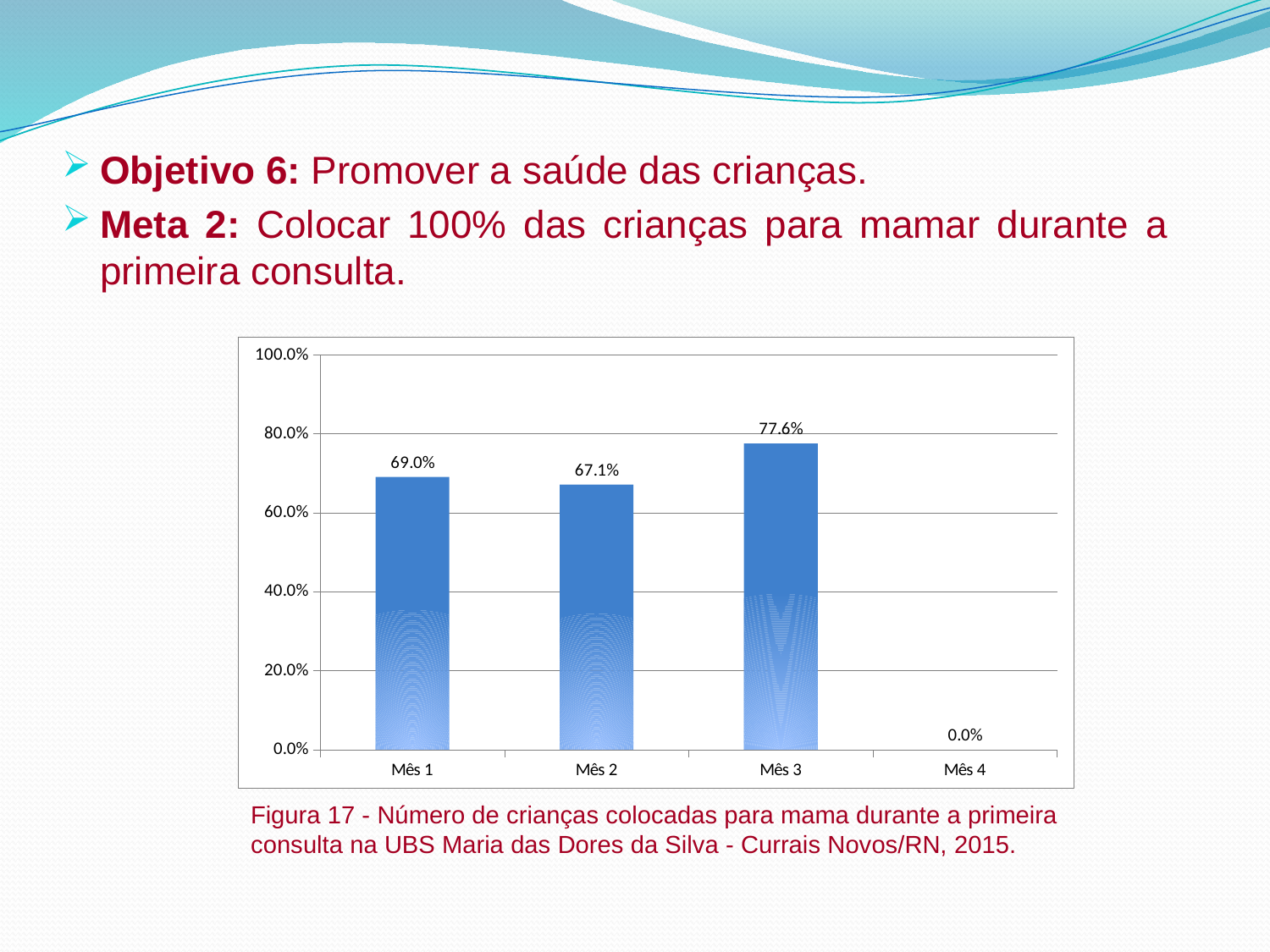
What is the value for Mês 1? 69.0% Which is larger, the value for Mês 2 or the value for Mês 3? Mês 3 What is the difference between the values for Mês 3 and Mês 1? 8.6% Which month has the highest value? Mês 3 How many categories are shown on the x axis? 4 What is the value for Mês 4? 0.0% What is the value for Mês 3? 77.6% What kind of chart is shown on the slide? Bar chart Which month has the lowest value? Mês 4 What is the value for Mês 2? 67.1% What is the difference between the values for Mês 1 and Mês 2? 1.9% What is the highest value shown on the y axis? 100.0%